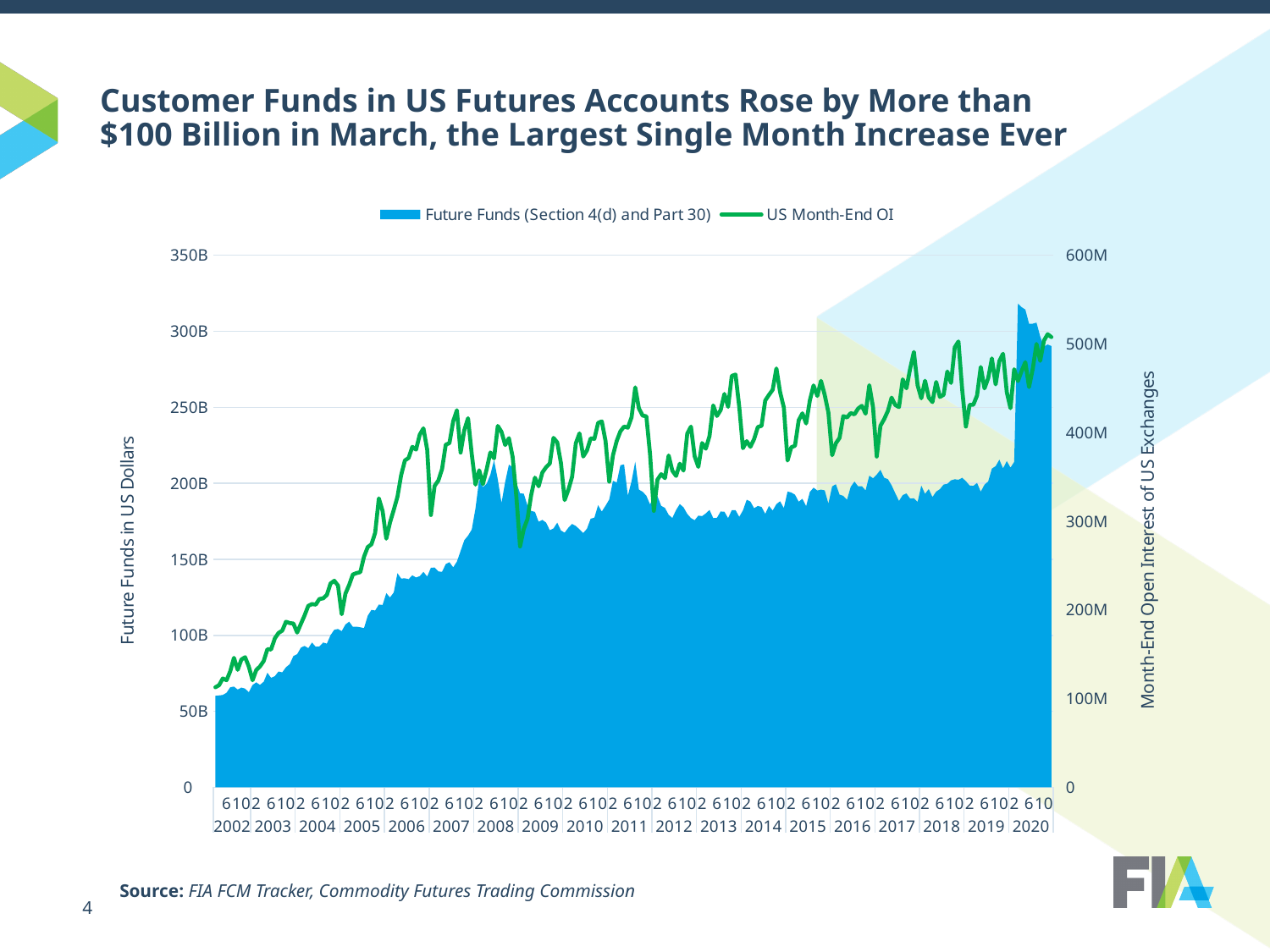
In which year do Future Funds reach their highest level? 2020 Do Future Funds generally rise or fall from 2002 to 2020? rise How many years are labelled along the x axis? 19 Is the US Month-End OI at the start of 2002 greater or less than 200M? less Is the value of Future Funds at the start of 2002 greater or less than 100B? less How many series does the legend list? 2 What are the two series named in the legend? Future Funds (Section 4(d) and Part 30) and US Month-End OI Which is larger, US Month-End OI in 2008 or in 2002? 2008 Is the peak value of Future Funds in 2020 greater or less than 300B? greater What is the title of the right-hand vertical axis? Month-End Open Interest of US Exchanges In which year are Future Funds at their lowest level? 2002 What kind of chart is shown on the slide? area chart with a line series